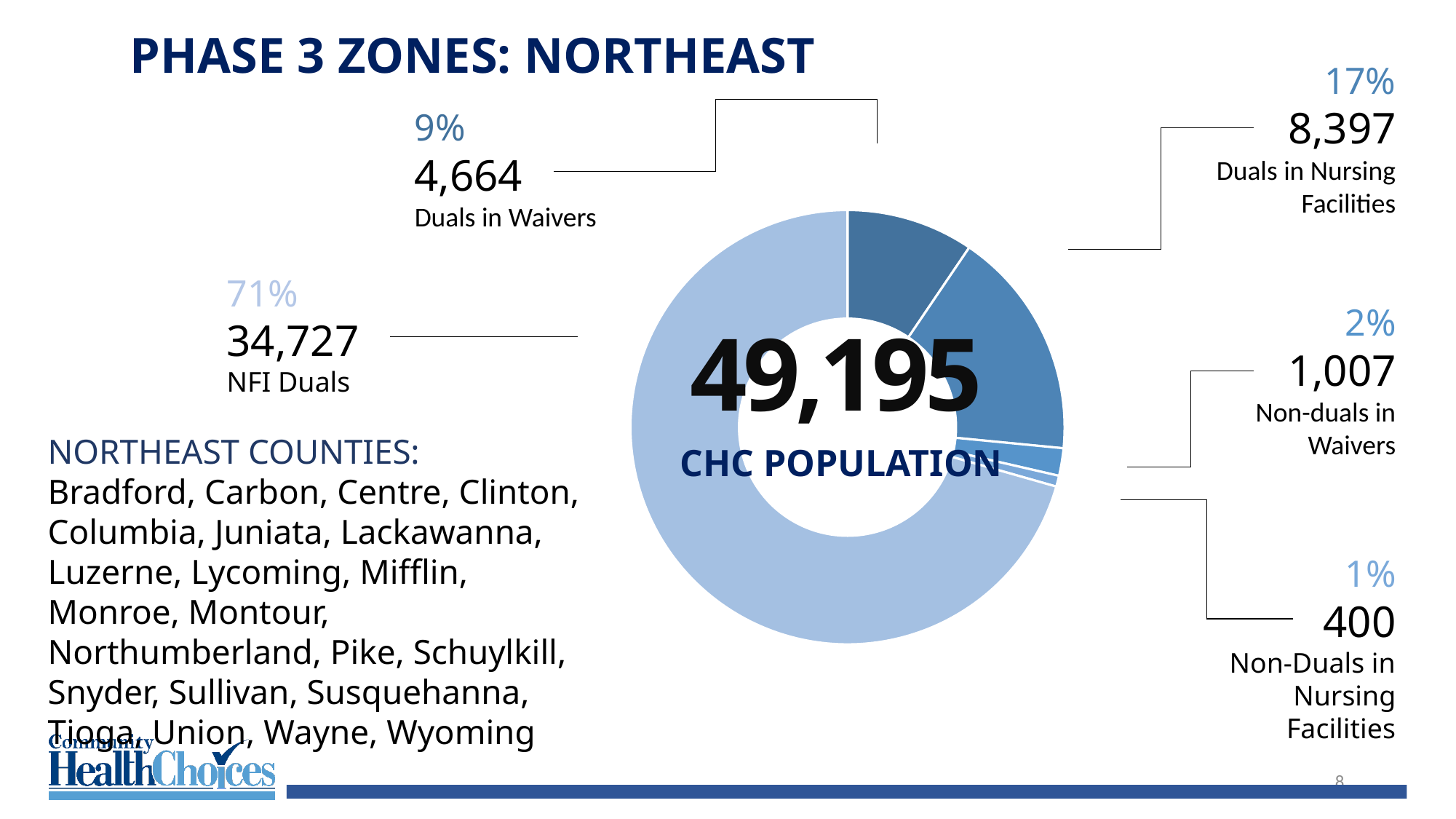
What kind of chart is shown on the slide? Pie chart (donut) What percentage share of the CHC population is Duals in Waivers? 9% What is the difference between the number of Duals in Nursing Facilities and the number of Duals in Waivers? 3,733 How many NFI Duals are shown on the chart? 34,727 Which is larger, Non-duals in Waivers or Non-Duals in Nursing Facilities? Non-duals in Waivers Which category has the largest share of the CHC population? NFI Duals What is the value for Duals in Nursing Facilities? 8,397 What percentage share of the CHC population is NFI Duals? 71% How many categories are shown in the chart? 5 Which category has the smallest share of the CHC population? Non-Duals in Nursing Facilities What is the total CHC population shown in the centre of the chart? 49,195 What is the value for Non-duals in Waivers? 1,007